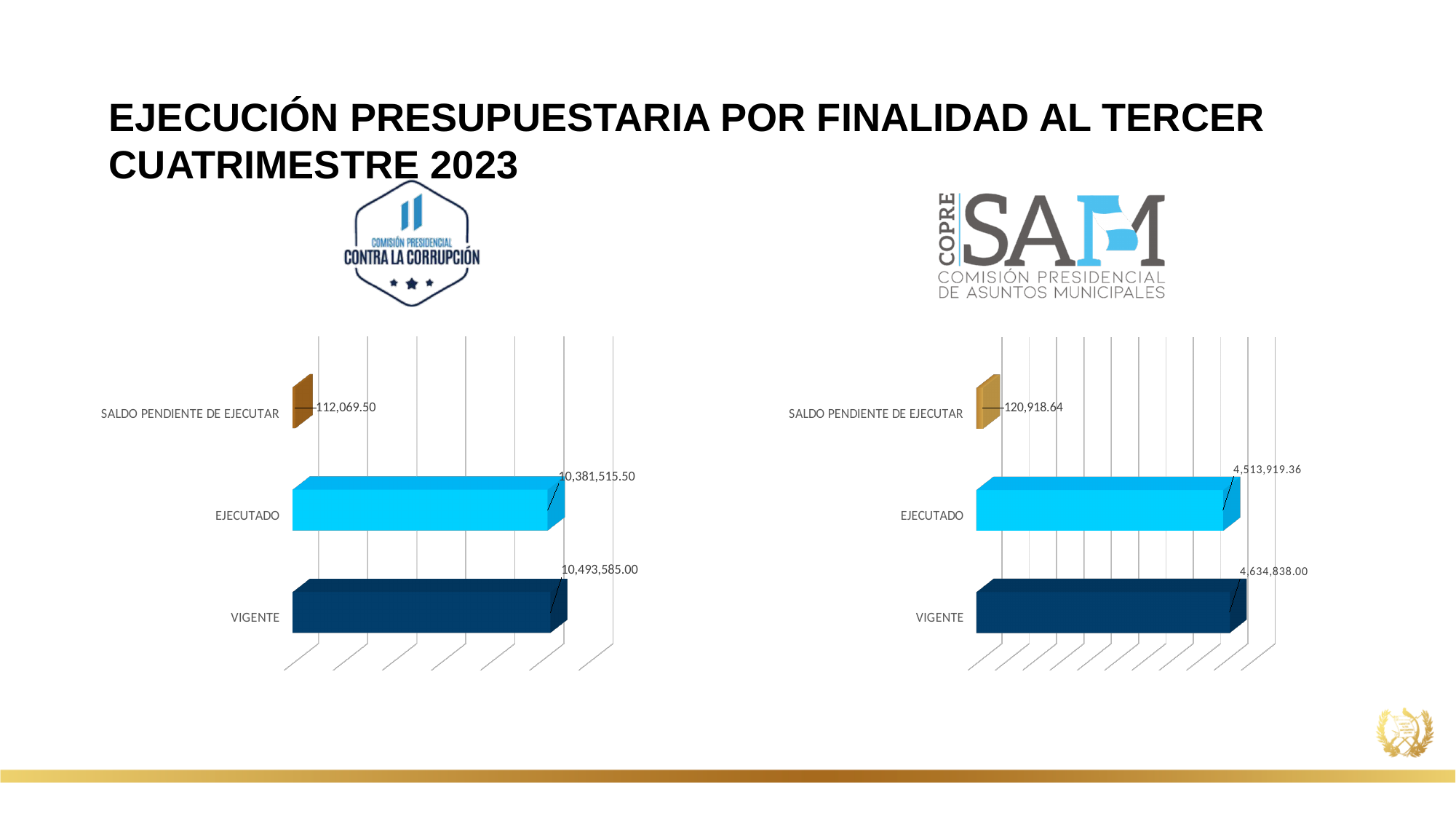
In the right chart, what is the value for VIGENTE? 4,634,838.00 In the right chart, what is the value for EJECUTADO? 4,513,919.36 What kind of chart is the left chart? Bar chart In the right chart, what is the difference between VIGENTE and EJECUTADO? 120,918.64 How many categories does the right chart show? 3 In the left chart, what is the value for VIGENTE? 10,493,585.00 In the right chart, what is the value for SALDO PENDIENTE DE EJECUTAR? 120,918.64 In the left chart, what is the value for SALDO PENDIENTE DE EJECUTAR? 112,069.50 In the left chart, what is the value for EJECUTADO? 10,381,515.50 In the right chart, which category has the highest value? VIGENTE In the left chart, what is the difference between VIGENTE and EJECUTADO? 112,069.50 In the left chart, which category has the lowest value? SALDO PENDIENTE DE EJECUTAR